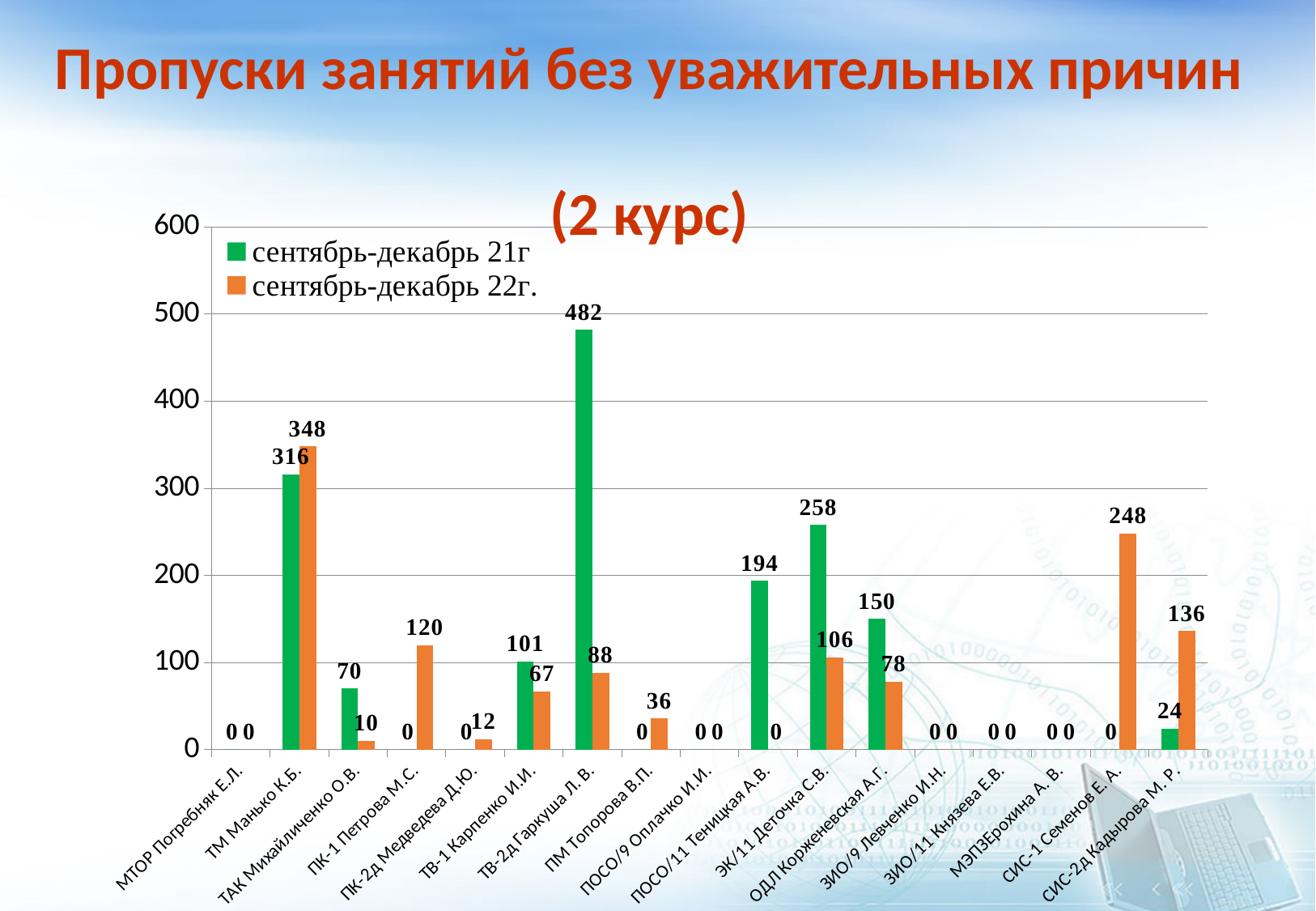
Which category has the highest value in the сентябрь-декабрь 22г. series? ТМ Манько К.Б. How many categories (groups) are shown on the x axis? 17 How many series does the legend list? 2 What kind of chart is shown on the slide? bar chart What is the value for ОДЛ Корженевская А.Г. in the сентябрь-декабрь 22г. series? 78 What is the value for ТВ-2д Гаркуша Л.В. in the сентябрь-декабрь 21г series? 482 What is the value for СИС-1 Семенов Е.А. in the сентябрь-декабрь 22г. series? 248 Which colour represents the сентябрь-декабрь 22г. series? orange Is the value for ПОСО/11 Теницкая А.В. in the сентябрь-декабрь 21г series greater or less than 100? greater For ЭК/11 Деточка С.В., which series has the larger value: сентябрь-декабрь 21г or сентябрь-декабрь 22г.? сентябрь-декабрь 21г What is the difference between the сентябрь-декабрь 22г. and сентябрь-декабрь 21г values for ТМ Манько К.Б.? 32 Which category has the highest value in the сентябрь-декабрь 21г series? ТВ-2д Гаркуша Л.В.